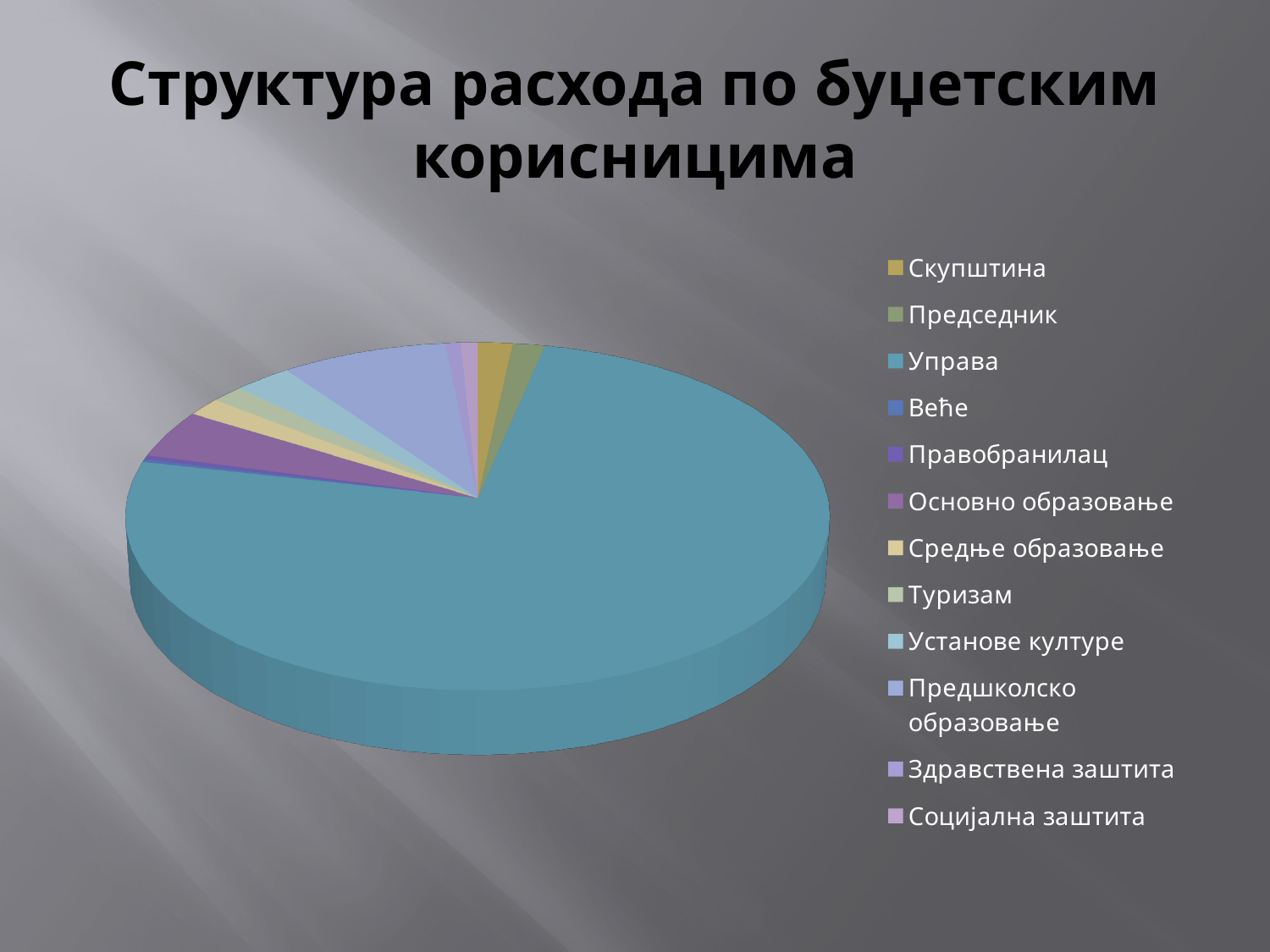
Which slice is larger, Предшколско образовање or Скупштина? Предшколско образовање Which legend entry is listed first in the chart legend? Скупштина Which slice is larger, Управа or Предшколско образовање? Управа Which slice is larger, Управа or Основно образовање? Управа What kind of chart is shown on the slide? Pie chart Does the Управа slice account for more or less than half of the pie? more What is the title of the chart? Структура расхода по буџетским корисницима How many categories does the legend of the pie chart list? 12 Which category has the largest slice of the pie? Управа